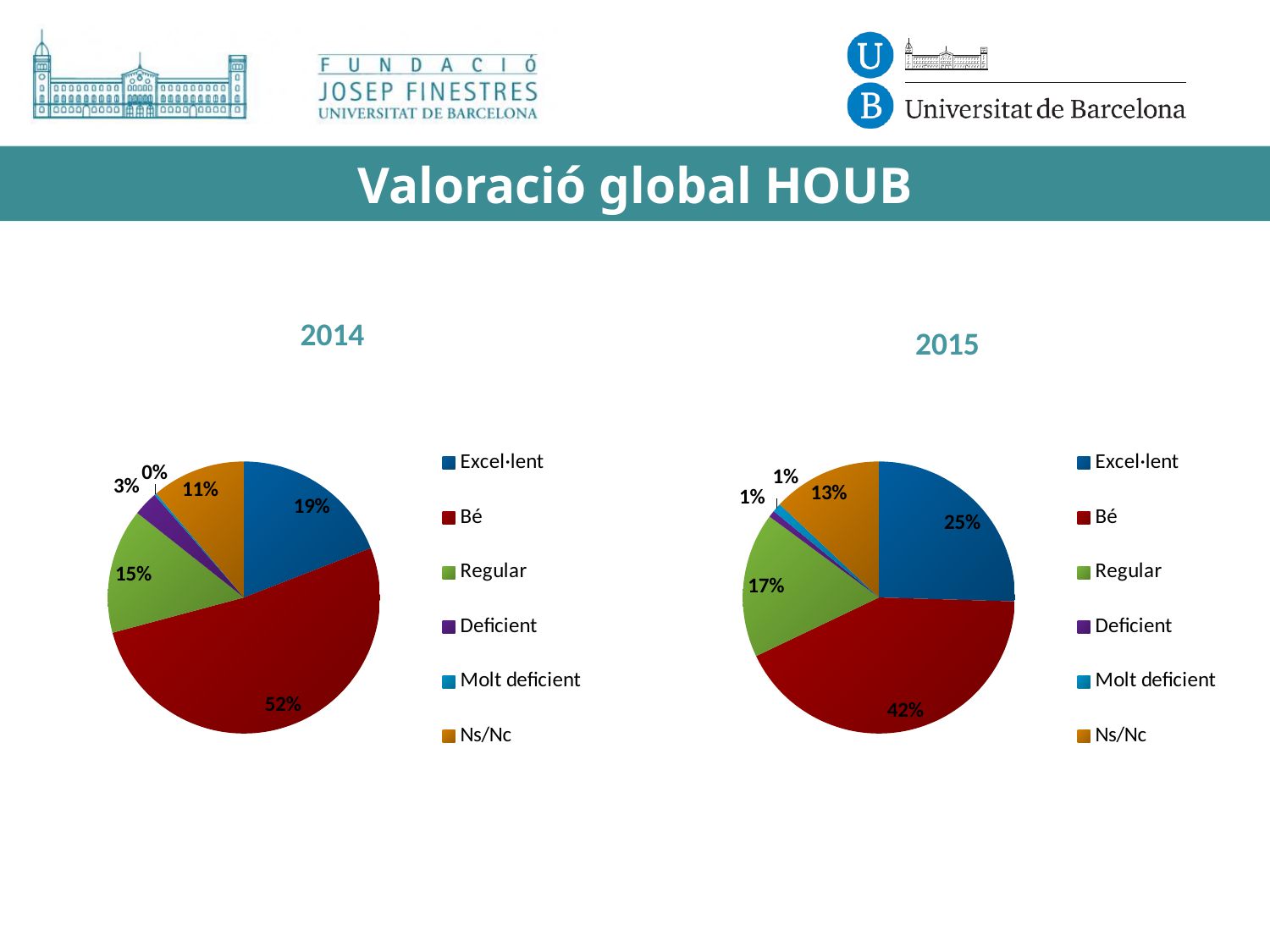
In the 2014 pie chart, what share is labelled for Ns/Nc? 11% Which is larger: the Excel·lent share in 2014 or the Excel·lent share in 2015? 2015 In the 2014 pie chart, which category has the smallest slice? Molt deficient How many categories does the legend of the 2015 pie chart list? 6 In the 2015 pie chart, what share is labelled for Excel·lent? 25% What kind of chart is used for the 2014 data? Pie chart In the 2015 pie chart, which category has the largest slice? Bé In the 2014 pie chart, which category has the largest slice? Bé What is the difference between the Bé share in 2014 and the Bé share in 2015? 10% In the 2015 pie chart, what colour is the Ns/Nc slice? Orange In the 2014 pie chart, what share is labelled for Bé? 52% In the 2015 pie chart, what share is labelled for Regular? 17%